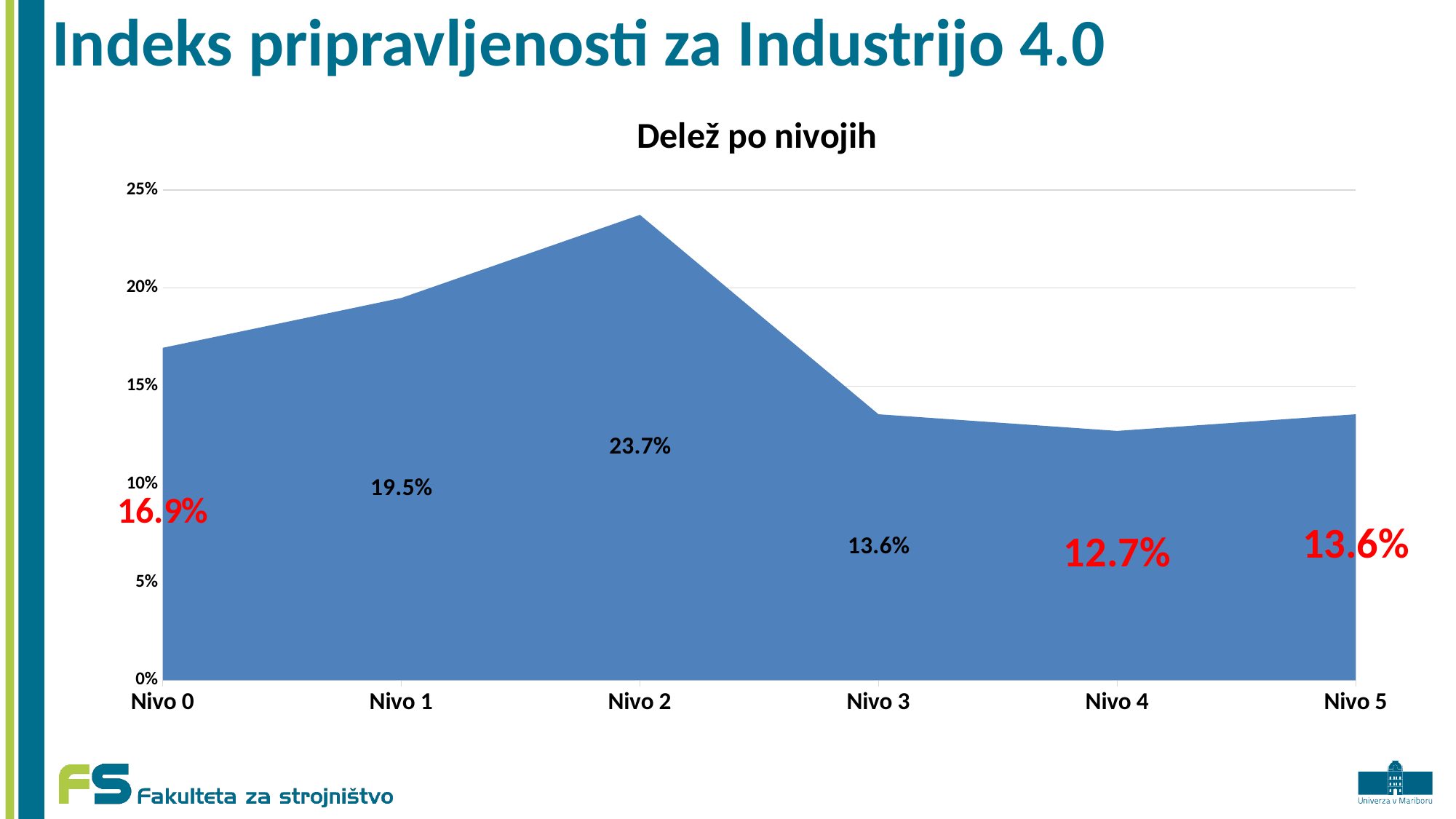
Which level (Nivo) has the lowest share? Nivo 4 What is the title of the chart? Delež po nivojih What kind of chart is shown on the slide? Area chart Which level (Nivo) has the highest share? Nivo 2 What is the value for Nivo 2 in the chart? 23.7% What is the difference between the values for Nivo 2 and Nivo 1? 4.2% What is the difference between the values for Nivo 0 and Nivo 4? 4.2% How many levels (categories) are shown on the x axis? 6 Is the value for Nivo 2 greater or less than 20%? greater Which is larger, the value for Nivo 1 or the value for Nivo 3? Nivo 1 What is the value for Nivo 4 in the chart? 12.7% What is the value for Nivo 0 in the chart? 16.9%